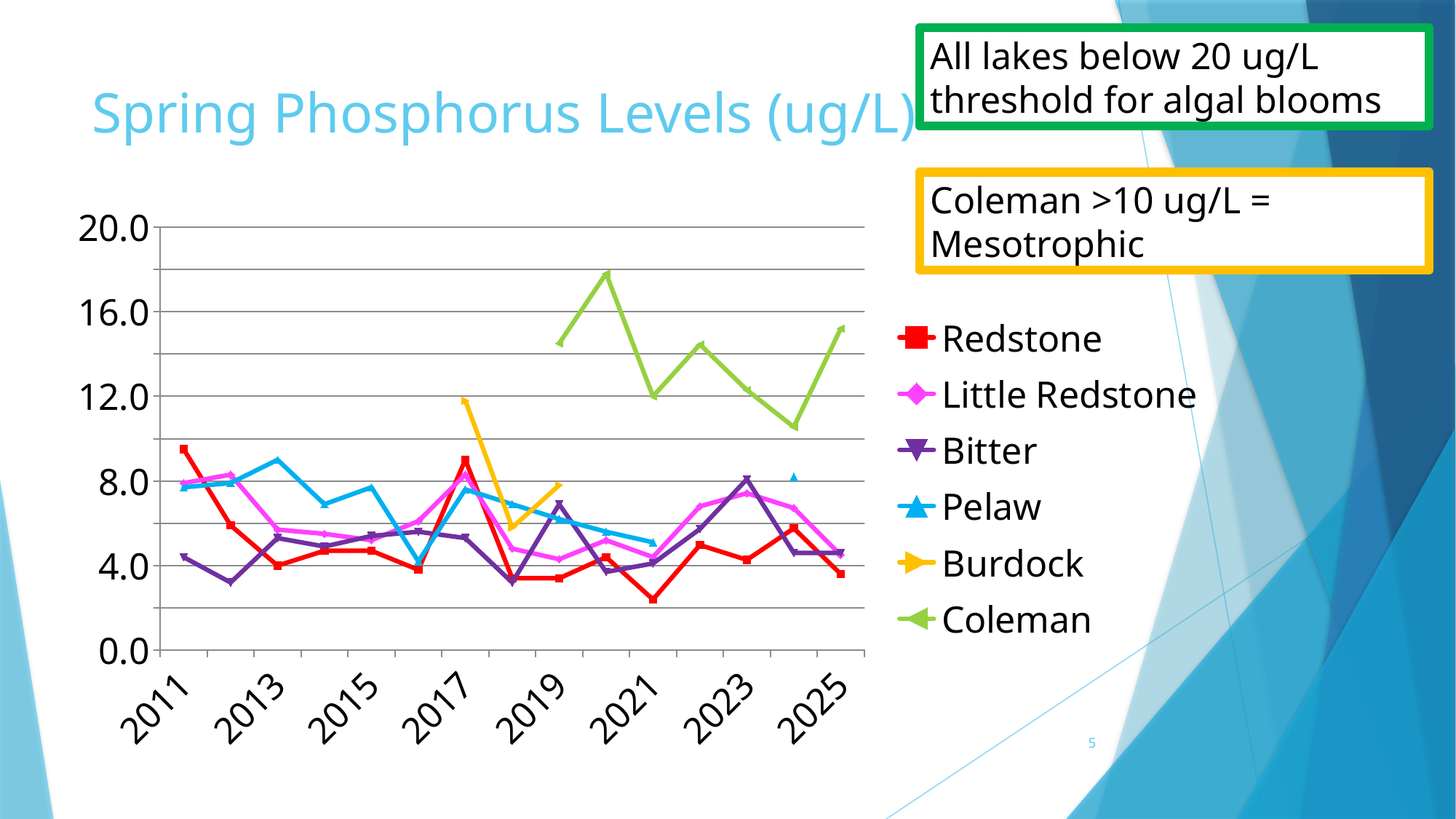
Which series is drawn in green? Coleman How many year labels are shown on the x axis? 8 Is the value for Redstone in 2021 greater or less than 4.0? less In 2023, which is higher: Bitter or Redstone? Bitter Is the value for Pelaw in 2013 greater or less than 8.0? greater What kind of chart is shown on the slide? Line chart How many series does the legend list? 6 What is the title of the chart? Spring Phosphorus Levels (ug/L) In 2011, which is higher: Redstone or Bitter? Redstone Is the value for Redstone in 2011 greater or less than 8.0? greater Which lake has the highest phosphorus values on the chart? Coleman